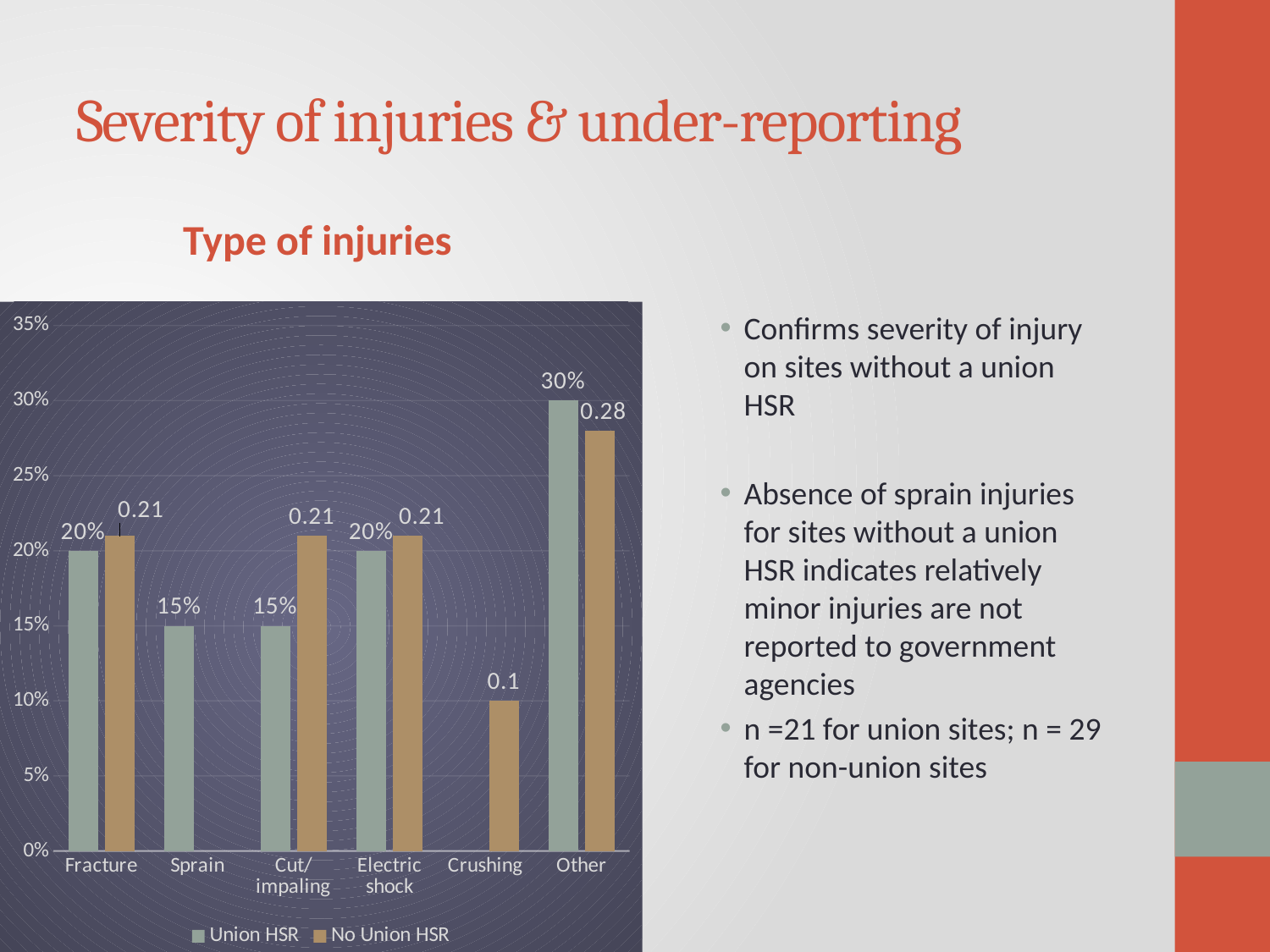
What is the Union HSR value for Other? 30% Is the Union HSR value for Other greater or less than 25%? greater What is the Union HSR value for Sprain? 15% Which category has the highest Union HSR value? Other How many injury categories are shown on the x axis? 6 What is the No Union HSR value for Other? 0.28 Which is larger for Union HSR: Other or Electric shock? Other What is the difference between the Union HSR values for Fracture and Sprain? 5% What is the No Union HSR value for Crushing? 0.1 Which category has the highest No Union HSR value? Other How many series does the legend list? 2 What is the Union HSR value for Fracture? 20%